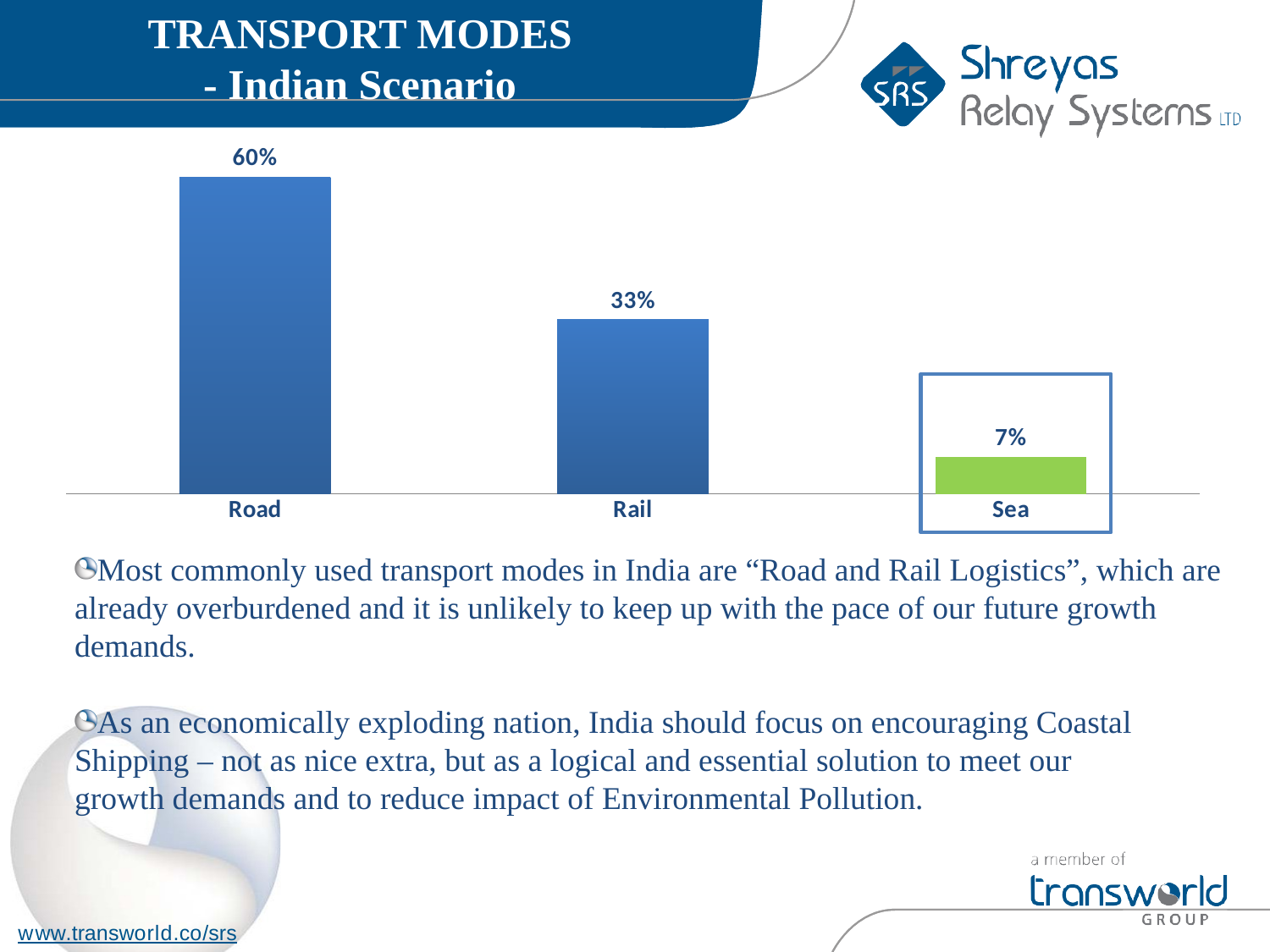
What is the value for Rail? 33% What is the difference between the values for Rail and Sea? 26% Do the values rise or fall from Road to Sea along the x axis? Fall What kind of chart is shown on the slide? Bar chart What is the difference between the values for Road and Rail? 27% Which bar is coloured green rather than blue? Sea What is the value for Sea? 7% Which transport mode has the lowest value? Sea Which is larger, the value for Rail or the value for Sea? Rail What is the value for Road? 60% Which transport mode has the highest value? Road How many transport modes are shown in the chart? 3